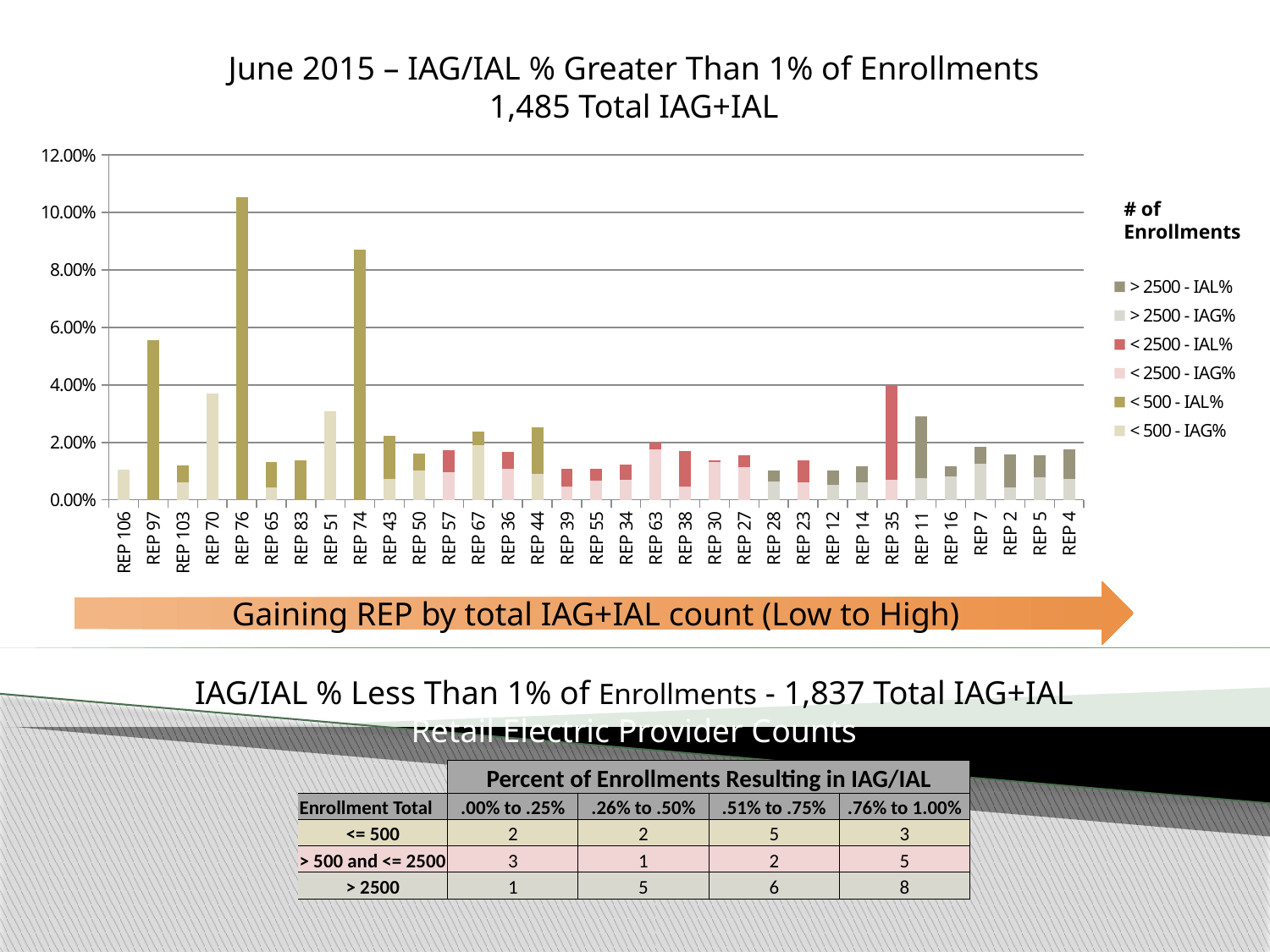
Which has the larger total bar, REP 97 or REP 70? REP 97 Is the total value for REP 70 greater or less than 4.00%? less What kind of chart is shown on the slide? Stacked bar chart Which REP has the highest total bar in the chart? REP 76 Which has the larger total bar, REP 76 or REP 74? REP 76 How many REP categories are plotted along the x axis of the chart? 33 How many series does the chart's legend list? 6 Is the total value for REP 74 greater or less than 8.00%? greater Is the total value for REP 11 greater or less than 2.00%? greater What is the title of the chart? June 2015 – IAG/IAL % Greater Than 1% of Enrollments 1,485 Total IAG+IAL